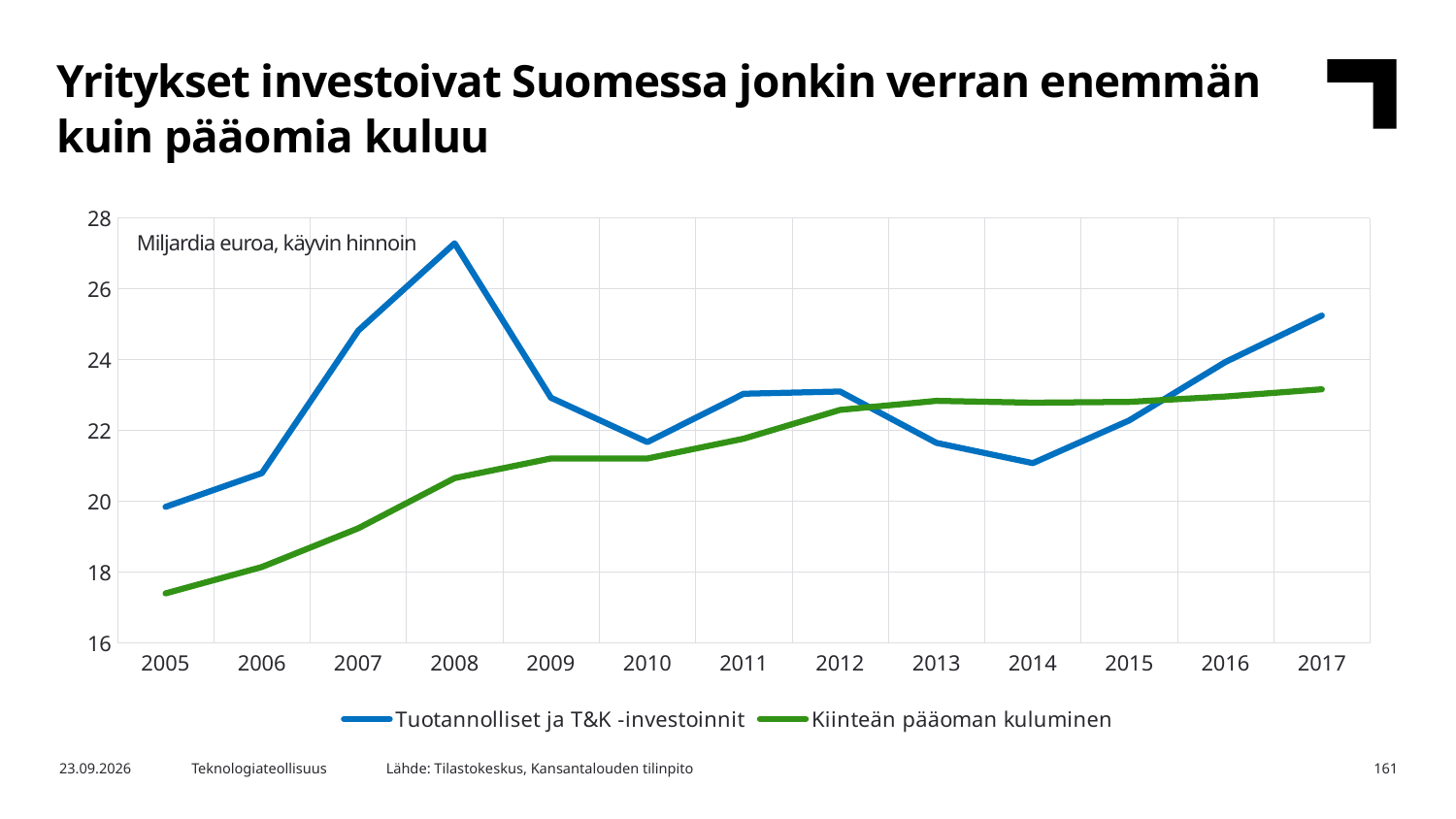
How many years are shown on the x axis? 13 What type of chart is shown on the slide? Line chart In which year is the value for Tuotannolliset ja T&K -investoinnit lowest? 2005 Is the value for Kiinteän pääoman kuluminen in 2005 greater or less than 18? less Is the value for Tuotannolliset ja T&K -investoinnit in 2017 greater or less than 24? greater Does the value for Kiinteän pääoman kuluminen generally rise or fall from 2005 to 2017? Rise In which year is the value for Kiinteän pääoman kuluminen lowest? 2005 In 2008, which series has the larger value: Tuotannolliset ja T&K -investoinnit or Kiinteän pääoman kuluminen? Tuotannolliset ja T&K -investoinnit In which year is the value for Tuotannolliset ja T&K -investoinnit highest? 2008 Is the value for Tuotannolliset ja T&K -investoinnit in 2008 greater or less than 26? greater In 2014, which series has the larger value: Tuotannolliset ja T&K -investoinnit or Kiinteän pääoman kuluminen? Kiinteän pääoman kuluminen How many series does the legend list? 2